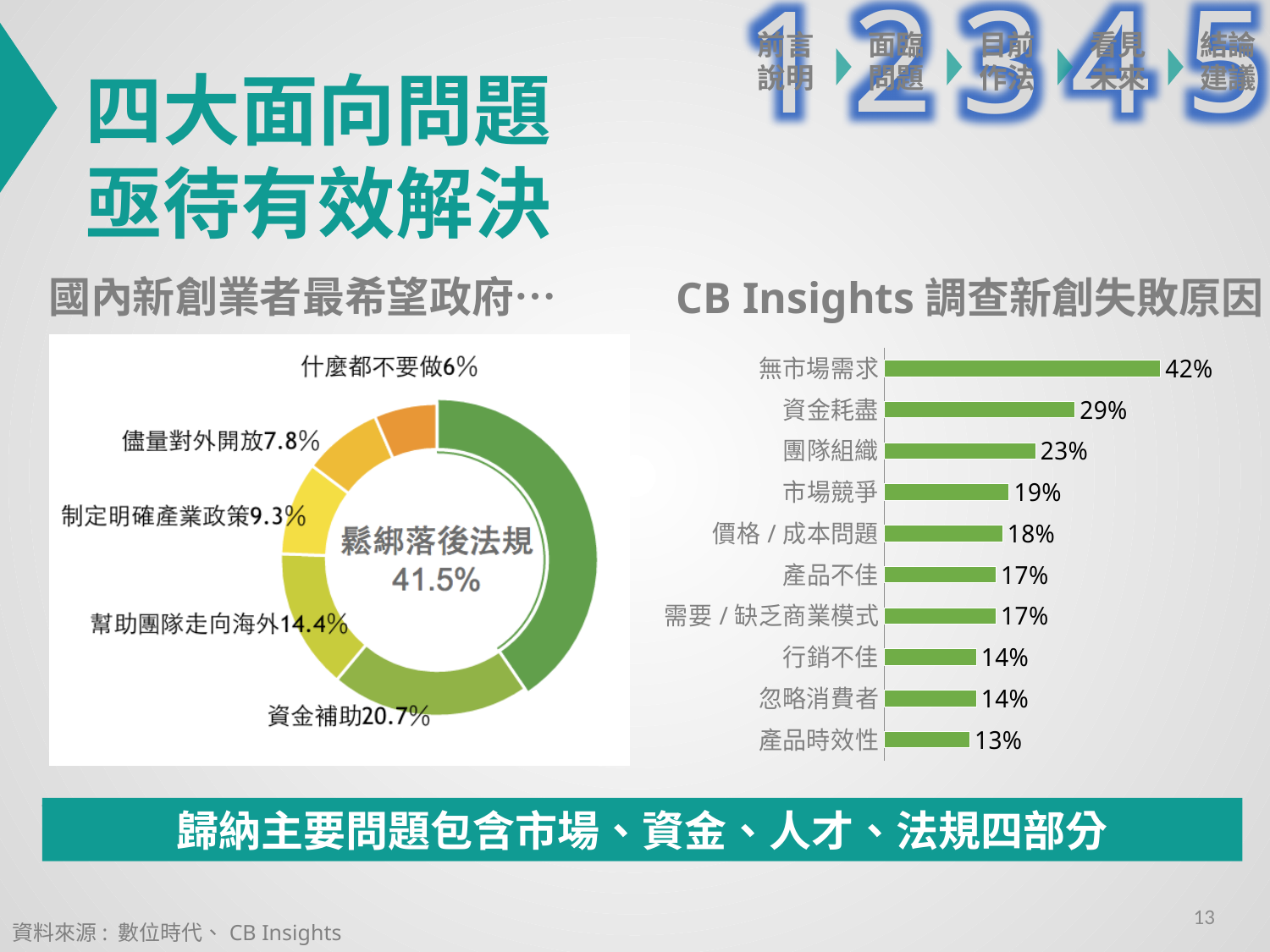
In the chart titled CB Insights 調查新創失敗原因, which category has the lowest value? 產品時效性 In the chart titled CB Insights 調查新創失敗原因, what is the difference between 無市場需求 and 資金耗盡? 13% In the chart titled 國內新創業者最希望政府…, what share is labelled for 鬆綁落後法規? 41.5% In the chart titled 國內新創業者最希望政府…, how many categories are shown? 6 In the chart titled CB Insights 調查新創失敗原因, how many categories are listed? 10 What kind of chart is the one titled 國內新創業者最希望政府…? Donut (pie) chart In the chart titled 國內新創業者最希望政府…, what share is labelled for 資金補助? 20.7% In the chart titled CB Insights 調查新創失敗原因, what is the value for 無市場需求? 42% In the chart titled CB Insights 調查新創失敗原因, what is the value for 團隊組織? 23% In the chart titled 國內新創業者最希望政府…, which category has the smallest share? 什麼都不要做 What kind of chart is the one titled CB Insights 調查新創失敗原因? Bar chart In the chart titled CB Insights 調查新創失敗原因, which is larger, 市場競爭 or 行銷不佳? 市場競爭